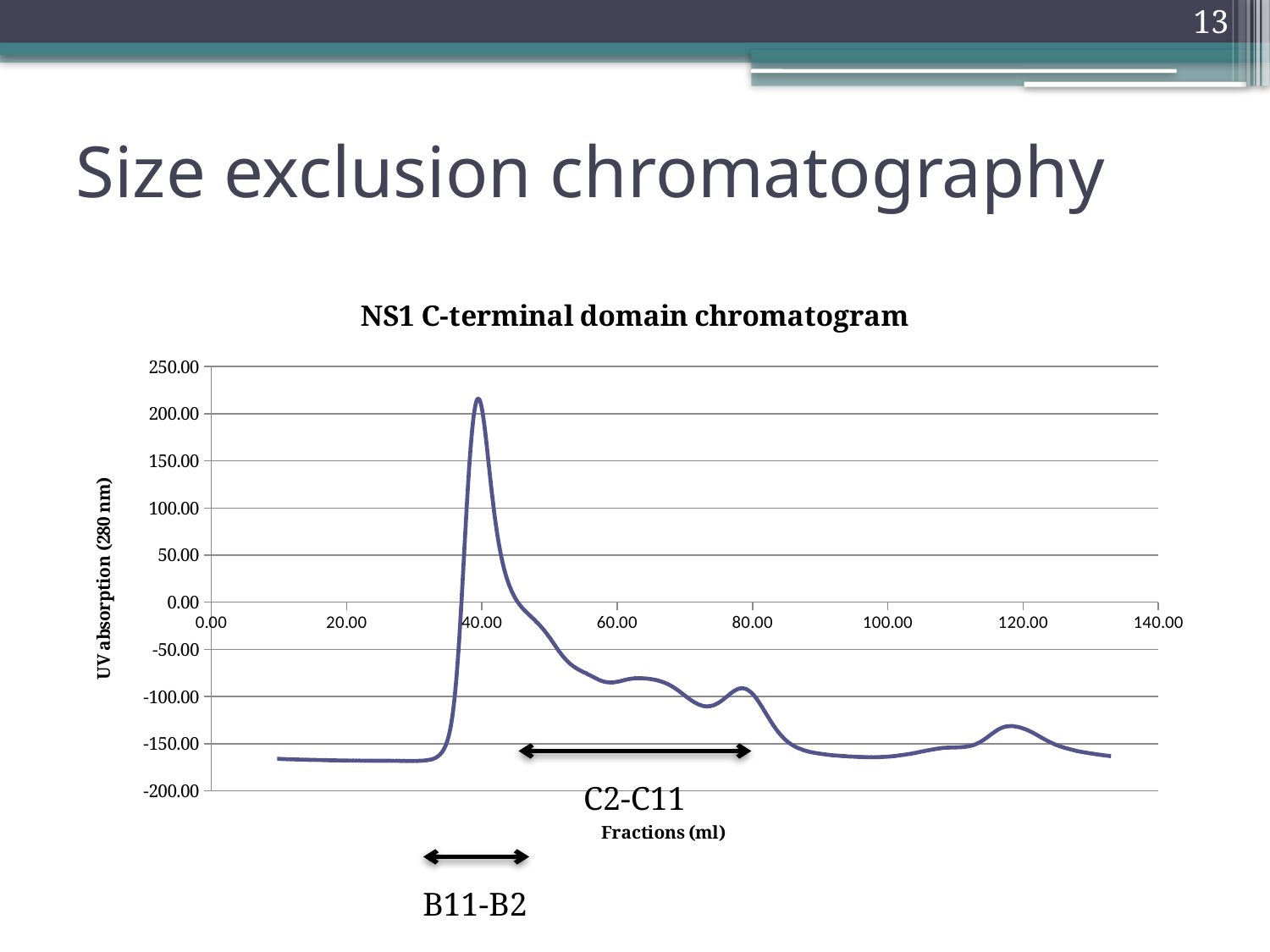
What kind of chart is shown on the slide? line chart Is the value of the curve at 20.00 ml greater or less than -150? less Is the value of the curve at 40.00 ml larger or smaller than the value at 100.00 ml? larger Is the peak value of the curve greater or less than 200? greater Near which x-axis tick does the curve reach its highest value? 40.00 What is the label of the vertical axis of the chart? UV absorption (280 nm) Between 40.00 ml and 60.00 ml, does the curve rise or fall? fall Is the value of the curve at 80.00 ml greater or less than 0? less How many data series are plotted in the chart? 1 What is the title of the chart? NS1 C-terminal domain chromatogram